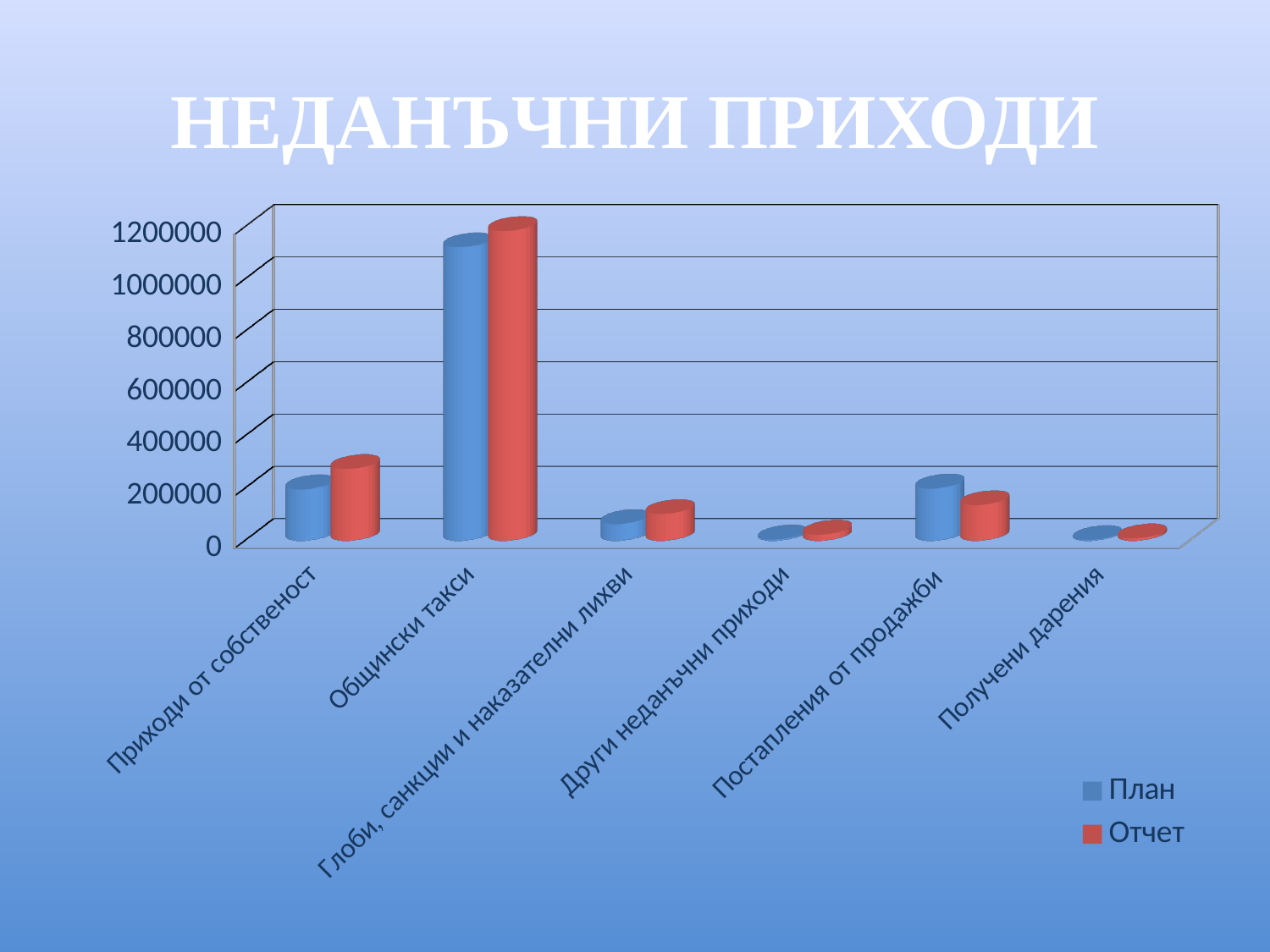
Which category has the lowest value for the Отчет series? Получени дарения What is the title of the chart? НЕДАНЪЧНИ ПРИХОДИ How many series does the legend list? 2 For Постъпления от продажби, which series has the larger value, План or Отчет? План What kind of chart is shown on the slide? bar chart How many categories are shown on the x axis? 6 Which category has the highest value for the Отчет series? Общински такси Which category has the highest value for the План series? Общински такси For Приходи от собственост, which series has the larger value, План or Отчет? Отчет Is the Отчет value for Приходи от собственост greater or less than 200000? greater Is the Отчет value for Глоби, санкции и наказателни лихви greater or less than 200000? less Is the План value for Общински такси greater or less than 1000000? greater